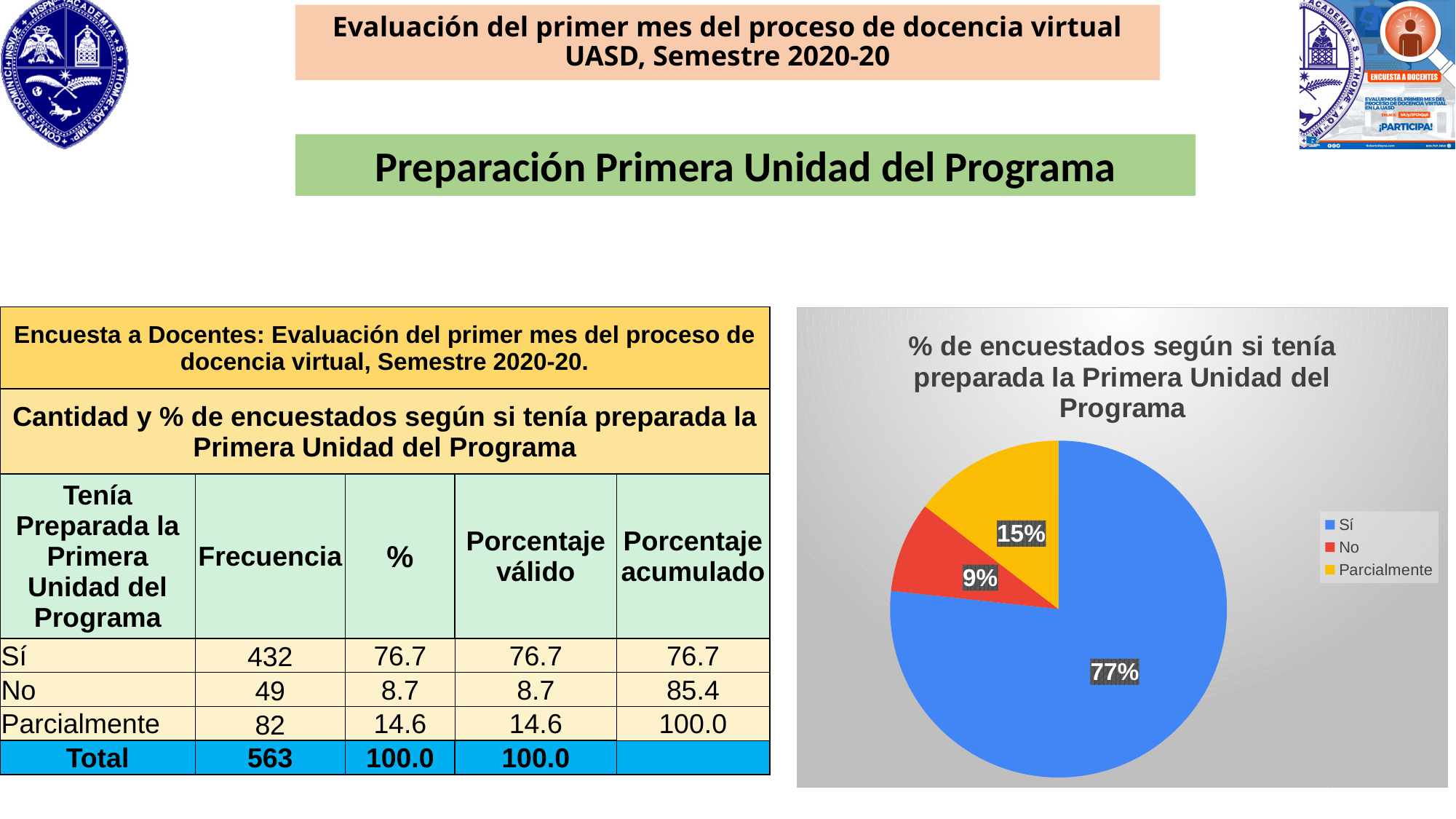
Which category has the largest slice in the pie chart? Sí What is the difference in percentage points between the 'Sí' slice and the 'Parcialmente' slice in the pie chart? 62 Which colour represents 'No' in the pie chart? red In the pie chart, which is larger, the slice for 'Parcialmente' or the slice for 'No'? Parcialmente What percentage does the pie chart show for 'No'? 9% How many slices does the pie chart have? 3 What percentage does the pie chart show for 'Parcialmente'? 15% What percentage does the pie chart show for 'Sí'? 77% What kind of chart is shown on the slide? pie chart Which category has the smallest slice in the pie chart? No What is the title of the pie chart? % de encuestados según si tenía preparada la Primera Unidad del Programa How many entries does the legend of the pie chart list? 3